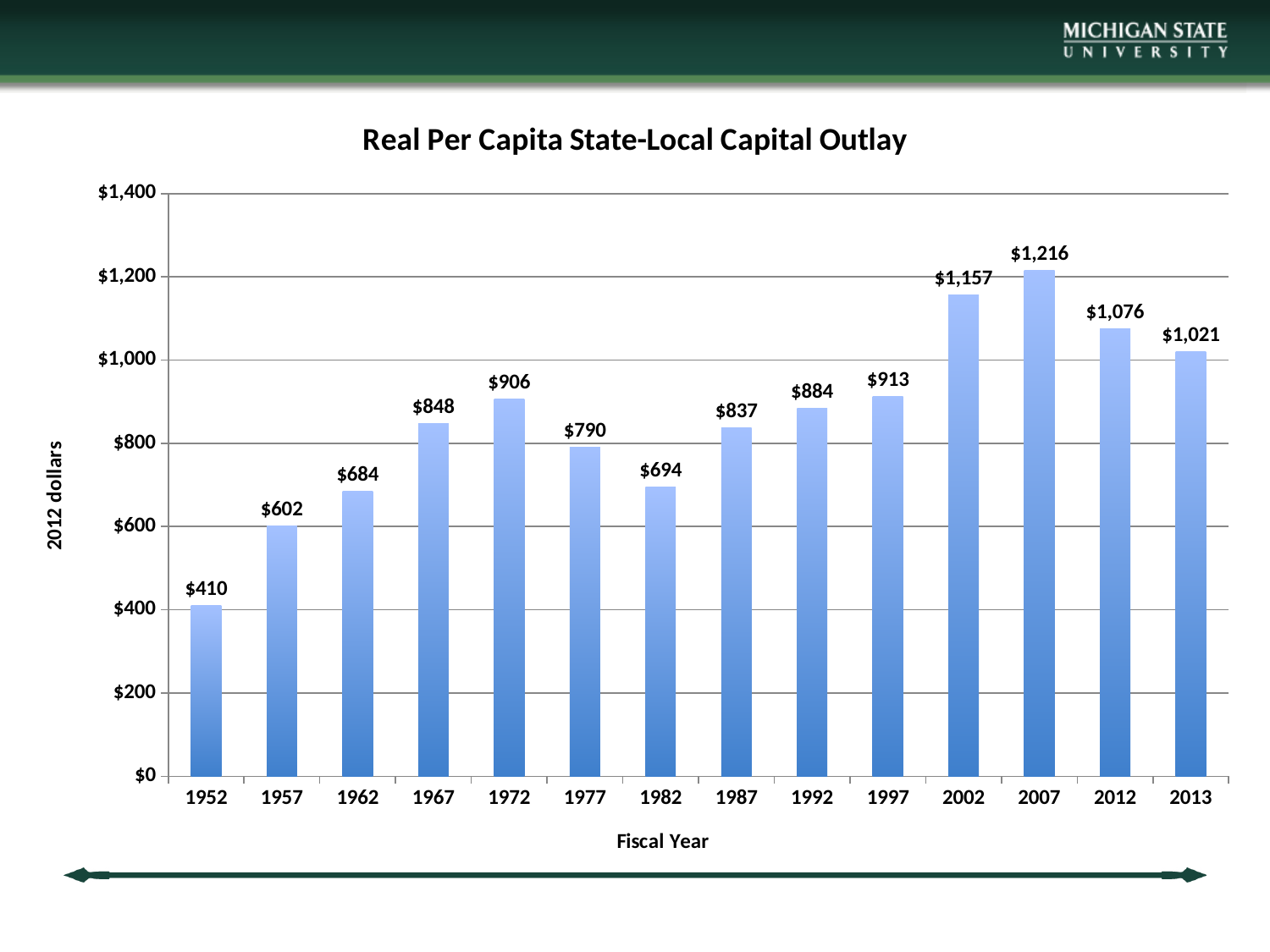
What is the real per capita state-local capital outlay for fiscal year 1952? $410 What is the difference between the values for 1972 and 1977? $116 What kind of chart is shown on the slide? bar chart Is the value for 1997 greater or less than $1,000? less What is the value shown for fiscal year 2002? $1,157 How many fiscal years are shown on the x axis? 14 What is the value shown for fiscal year 1982? $694 What is the title of the chart? Real Per Capita State-Local Capital Outlay What is the difference between the values for 2007 and 2013? $195 Which fiscal year has the highest real per capita state-local capital outlay? 2007 Which fiscal year has the lowest real per capita state-local capital outlay? 1952 Which is larger, the value for 1967 or the value for 1987? 1967